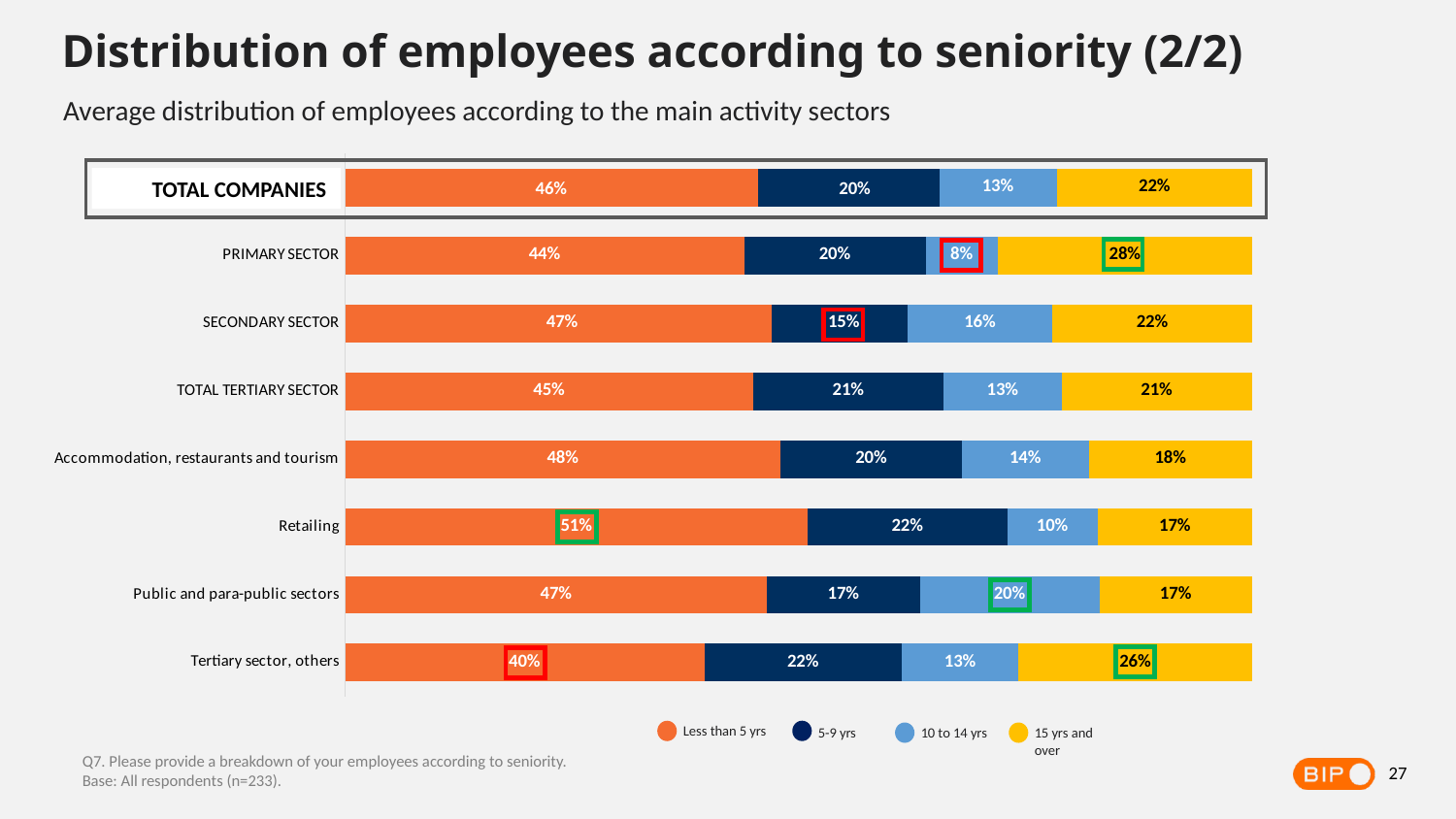
What is the share of employees with 15 years and over in the Primary sector? 28% What percentage of employees in Public and para-public sectors have 10 to 14 years of seniority? 20% What is the difference between the 15 yrs and over share for the Primary sector and for Retailing? 11 percentage points Which category has the lowest share of employees with 10 to 14 years of seniority? Primary sector What percentage of employees in the Retailing sector have less than 5 years of seniority? 51% Which category has the lowest share of employees with less than 5 years of seniority? Tertiary sector, others What kind of chart is shown on the slide? Stacked bar chart Which is larger: the 5-9 yrs share for the Secondary sector or for Total tertiary sector? Total tertiary sector How many categories (bars) are shown in the chart? 8 Which category has the highest share of employees with less than 5 years of seniority? Retailing How many series does the legend list? 4 Which colour represents the 'Less than 5 yrs' series in the chart? Orange